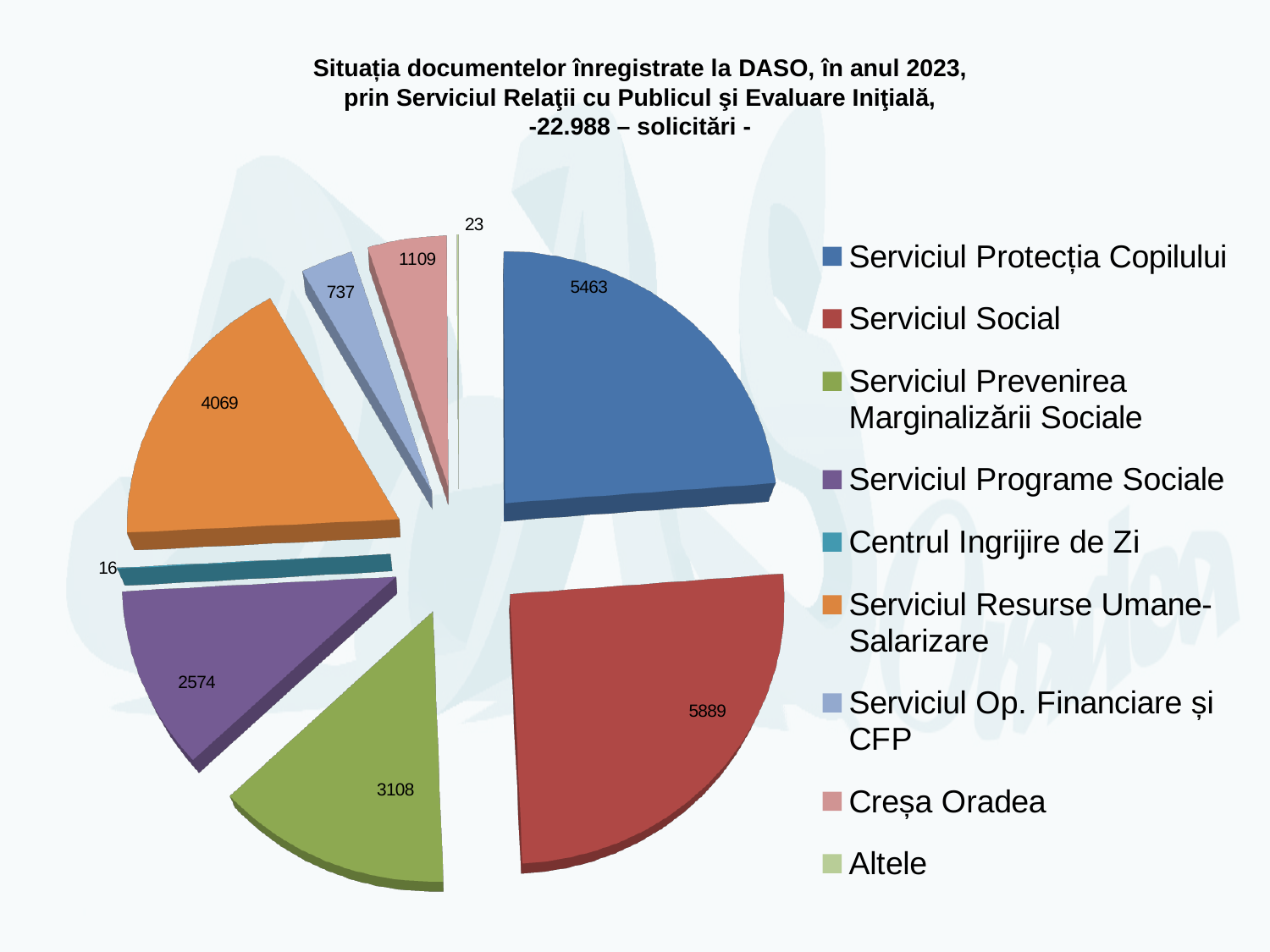
Which is larger, the value for Serviciul Prevenirea Marginalizării Sociale or the value for Serviciul Programe Sociale? Serviciul Prevenirea Marginalizării Sociale Which category has the smallest slice of the pie? Centrul Ingrijire de Zi What is the difference between the values for Serviciul Social and Serviciul Protecția Copilului? 426 What is the value for Centrul Ingrijire de Zi? 16 What type of chart is shown on the slide? Pie chart What colour is the slice for Serviciul Resurse Umane-Salarizare? Orange How many slices does the pie chart have? 9 What is the value for Creșa Oradea? 1109 What is the value for Serviciul Protecția Copilului? 5463 What is the value for Serviciul Resurse Umane-Salarizare? 4069 What is the difference between the values for Serviciul Op. Financiare și CFP and Altele? 714 Which category has the largest slice of the pie? Serviciul Social